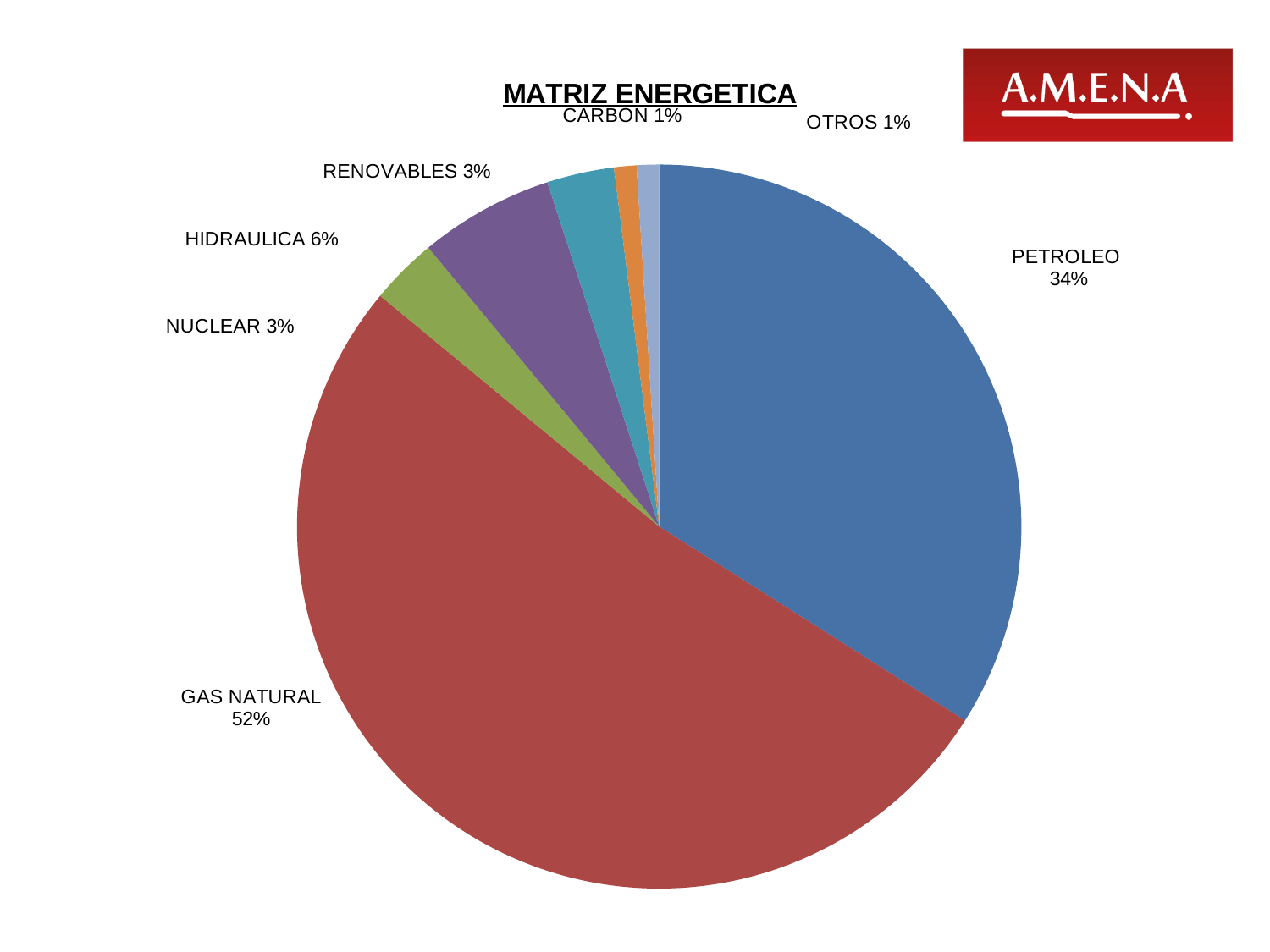
What share of the pie does NUCLEAR have? 3% What is the combined share of GAS NATURAL and PETROLEO? 86% What type of chart is shown on the slide? pie chart What share of the pie does PETROLEO have? 34% What share of the pie does CARBON have? 1% What share of the pie does HIDRAULICA have? 6% Which category has the largest share of the pie? GAS NATURAL What is the title of the chart? MATRIZ ENERGETICA Which is larger, the share of HIDRAULICA or the share of RENOVABLES? HIDRAULICA What share of the pie does GAS NATURAL have? 52% What is the difference between the shares of GAS NATURAL and PETROLEO? 18% How many categories are shown in the pie chart? 7